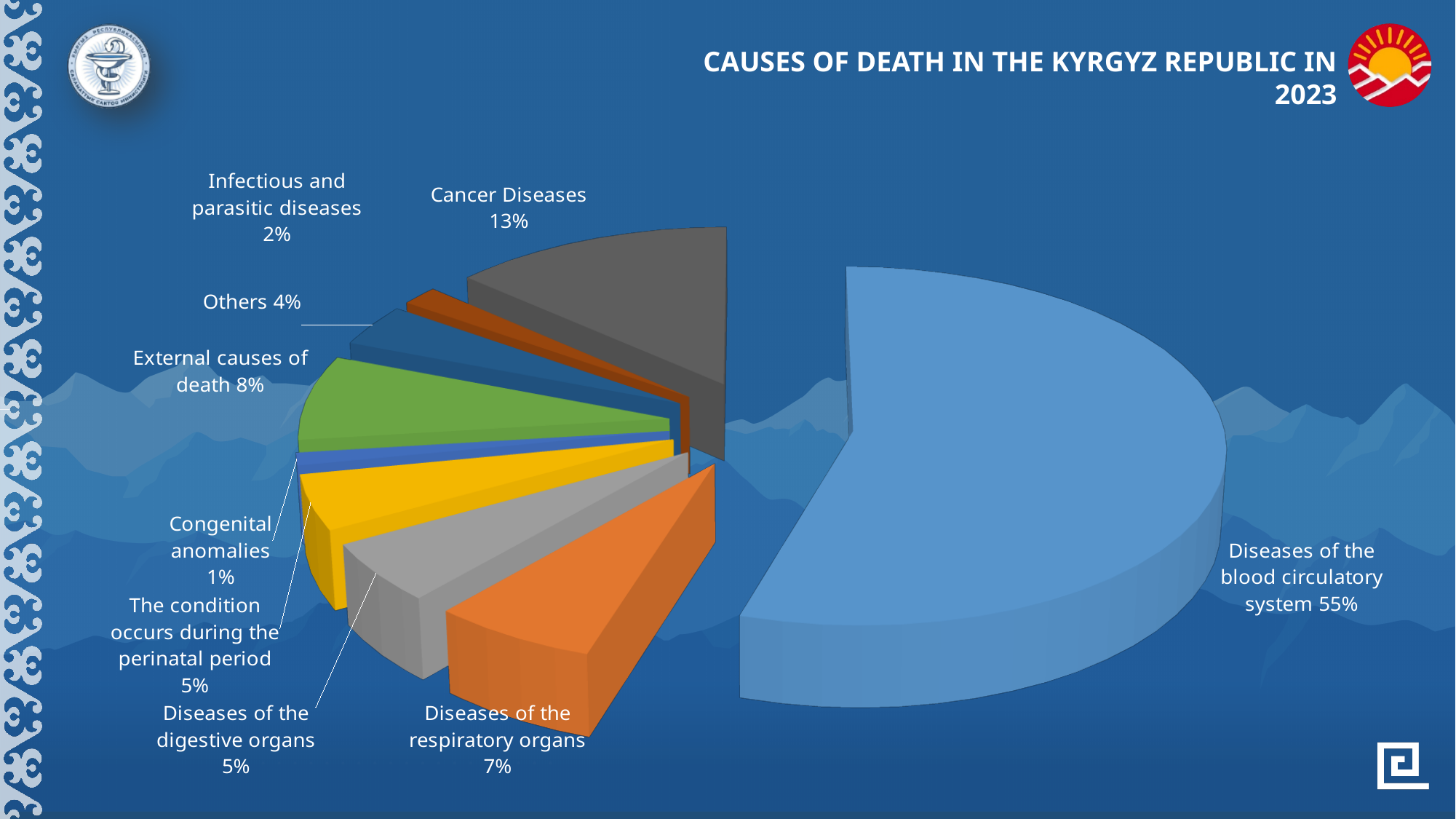
What kind of chart is shown on the slide? Pie chart How many categories are shown in the pie chart? 9 What percentage of deaths is due to cancer diseases? 13% What is the title of the chart on the slide? Causes of death in the Kyrgyz Republic in 2023 What share of deaths is attributed to infectious and parasitic diseases? 2% Which cause of death has the largest share in the pie chart? Diseases of the blood circulatory system Which has a larger share: external causes of death or diseases of the respiratory organs? External causes of death What share of deaths is attributed to external causes of death? 8% What is the difference in percentage points between diseases of the blood circulatory system and cancer diseases? 42 Which cause of death has the smallest share in the pie chart? Congenital anomalies What percentage of deaths is due to diseases of the respiratory organs? 7% What share of deaths is attributed to diseases of the blood circulatory system? 55%